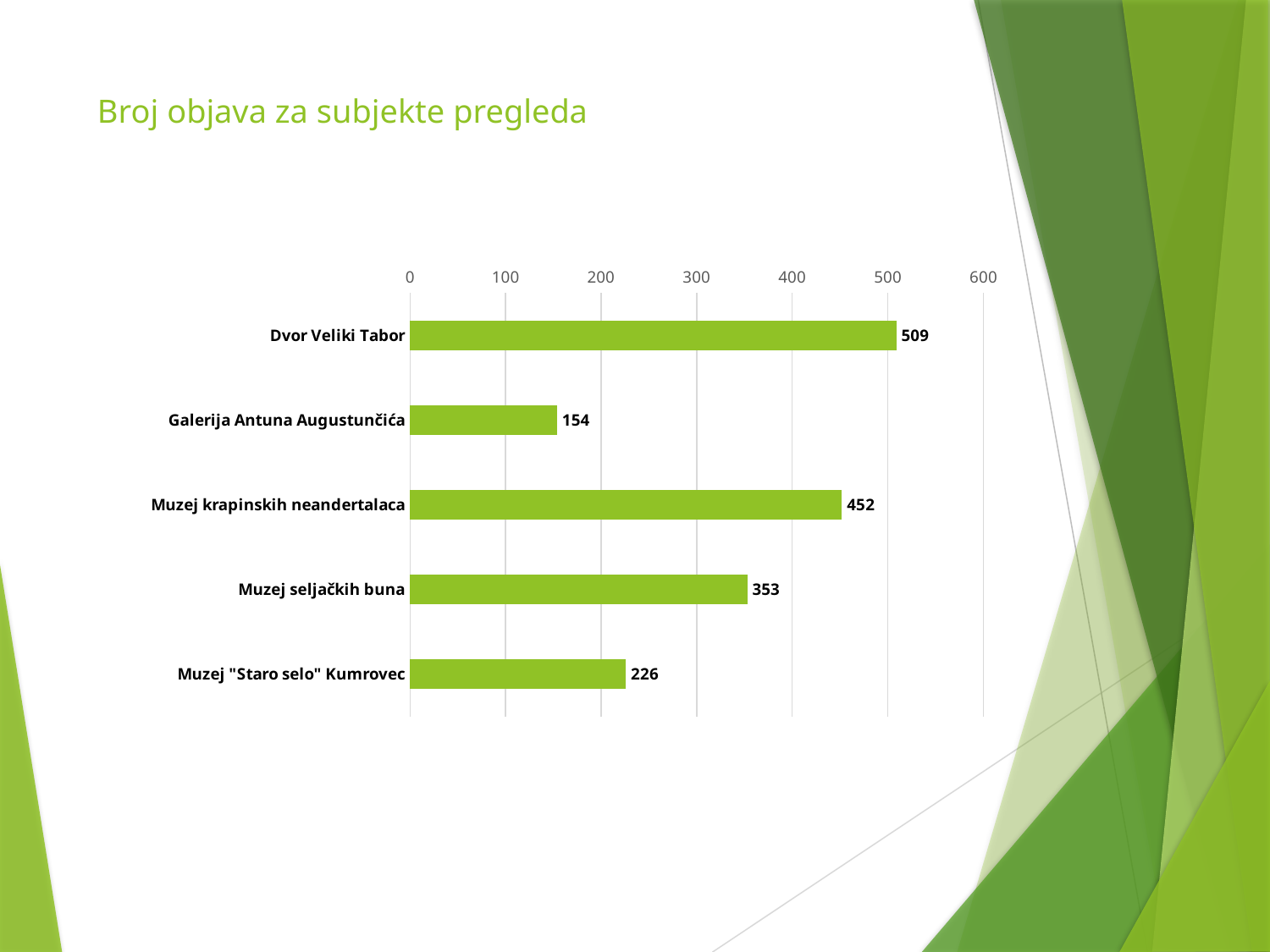
What is the difference between the values for Dvor Veliki Tabor and Muzej seljačkih buna? 156 Which is larger, the value for Muzej krapinskih neandertalaca or the value for Muzej "Staro selo" Kumrovec? Muzej krapinskih neandertalaca What is the value for Muzej krapinskih neandertalaca? 452 What kind of chart is shown on the slide? bar chart What is the value for Muzej "Staro selo" Kumrovec? 226 Which category has the highest value? Dvor Veliki Tabor Which category has the lowest value? Galerija Antuna Augustunčića Is the value for Muzej seljačkih buna greater or less than 300? greater How many categories are shown in the chart? 5 What is the value for Dvor Veliki Tabor? 509 What is the title of the slide? Broj objava za subjekte pregleda What is the value for Galerija Antuna Augustunčića? 154